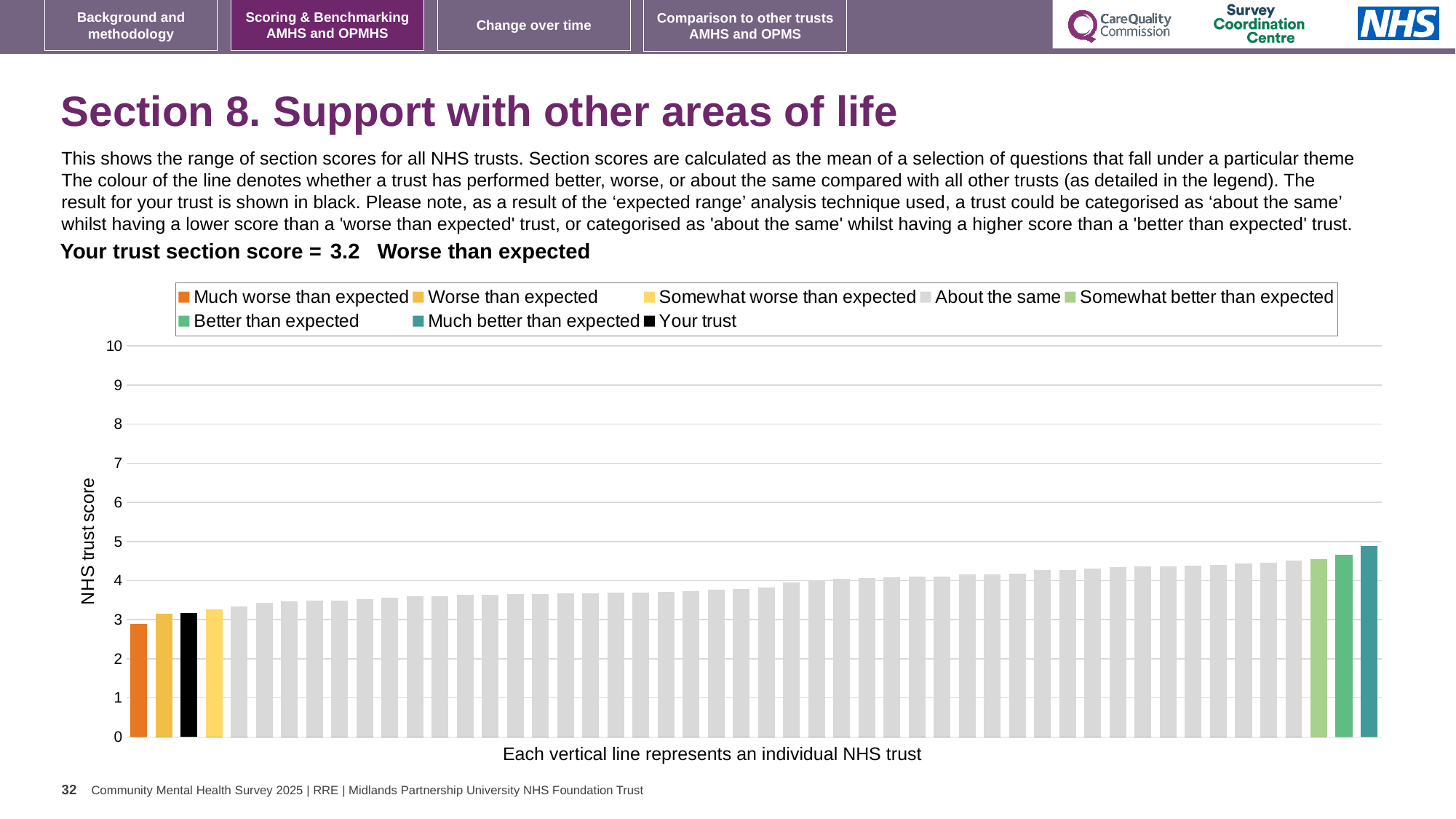
Is the value of the tallest bar on the chart greater or less than 4? greater How many bars are coloured as 'Much better than expected'? 1 Which legend category does the tallest bar belong to? Much better than expected Which legend category does the shortest bar belong to? Much worse than expected Is the value of the leftmost (orange) bar greater or less than 4? less How many entries does the chart legend list? 8 Is the value of the black 'Your trust' bar greater or less than 4? less What is the title of the vertical axis? NHS trust score What kind of chart is shown on the slide? bar chart What is the section score for your trust shown on the slide? 3.2 Do the bar values rise or fall from left to right along the x axis? rise Which performance category is your trust's section score labelled as? Worse than expected